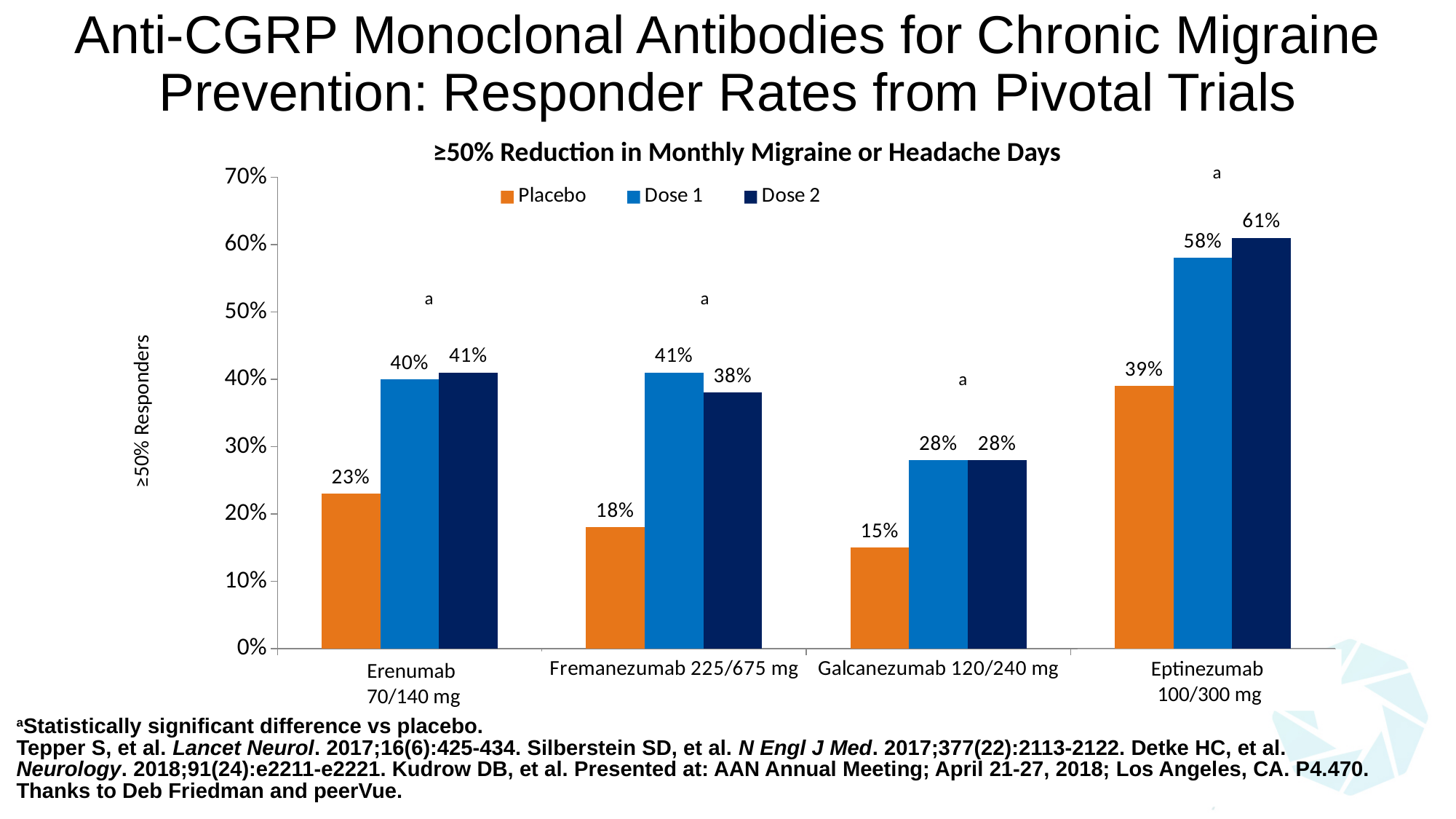
Which is larger for Fremanezumab 225/675 mg: the Dose 1 or the Dose 2 responder rate? Dose 1 What is the Placebo responder rate for Erenumab 70/140 mg? 23% Which drug has the lowest Placebo responder rate? Galcanezumab 120/240 mg What is the label of the y axis? ≥50% Responders What is the Dose 1 responder rate for Fremanezumab 225/675 mg? 41% Which drug has the highest Dose 1 responder rate? Eptinezumab 100/300 mg What is the title of the chart? ≥50% Reduction in Monthly Migraine or Headache Days What is the difference between the Dose 2 and Placebo responder rates for Eptinezumab 100/300 mg? 22% What is the Dose 2 responder rate for Eptinezumab 100/300 mg? 61% What kind of chart is shown on the slide? Bar chart How many drugs are shown on the x axis? 4 How many series does the legend list? 3